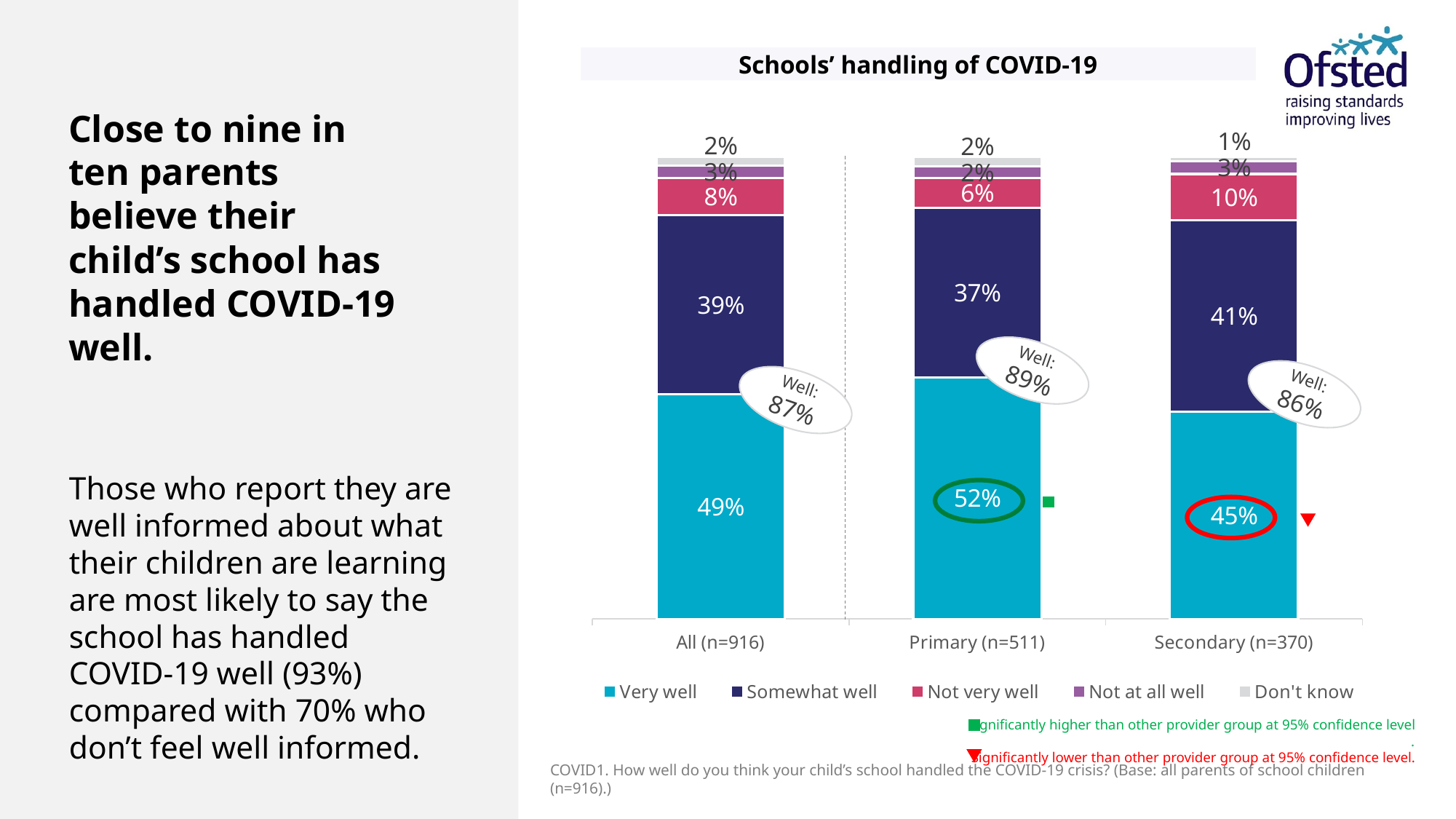
How many groups are shown on the x axis? 3 How many series does the legend list? 5 Which group has the highest 'Very well' percentage? Primary (n=511) Which group has the lowest 'Very well' percentage? Secondary (n=370) What kind of chart is shown? Stacked bar chart Which is larger: the 'Not very well' value for Secondary (n=370) or for All (n=916)? Secondary (n=370) What is the combined 'Well' figure shown for Primary (n=511)? 89% What is the 'Not very well' value for Primary (n=511)? 6% What percentage of parents in the All (n=916) group said their child's school handled COVID-19 very well? 49% What is the difference between the 'Very well' values for Primary (n=511) and Secondary (n=370)? 7% What is the 'Somewhat well' value for Secondary (n=370)? 41% What is the title of the chart? Schools' handling of COVID-19